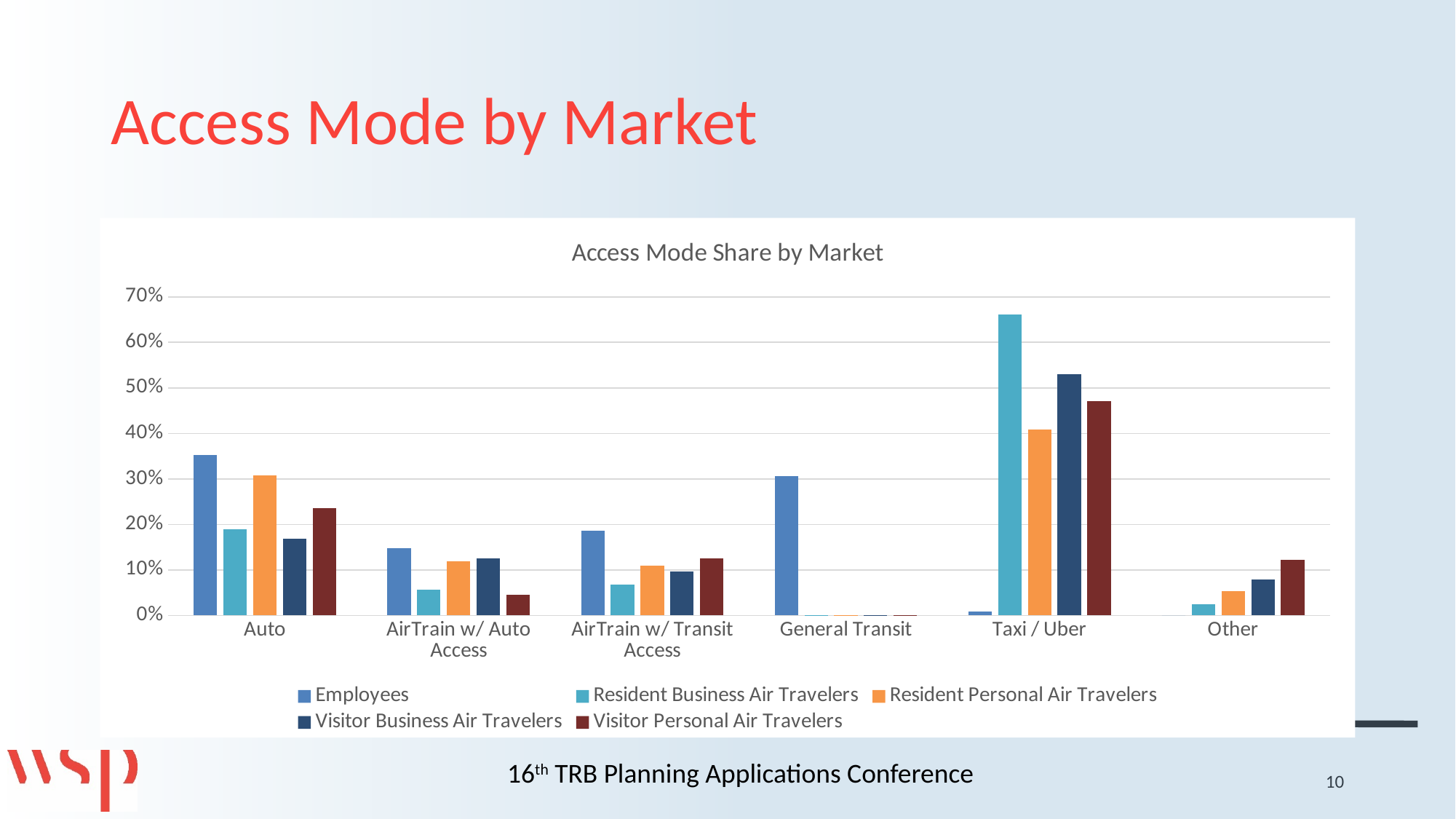
What is the title of the chart? Access Mode Share by Market In the Taxi / Uber category, which is larger: Visitor Business Air Travelers or Resident Personal Air Travelers? Visitor Business Air Travelers In the Auto category, which series has the highest bar? Employees Is the value for Employees in the Auto category greater or less than 30%? greater What kind of chart is shown on the slide? Bar chart How many access mode categories are shown on the x axis? 6 For which access mode is the Resident Business Air Travelers bar the highest? Taxi / Uber Is the value for Employees in the General Transit category greater or less than 20%? greater How many series does the legend list? 5 Is the value for Visitor Personal Air Travelers in the Other category greater or less than 20%? less In the Taxi / Uber category, which series has the lowest bar? Employees